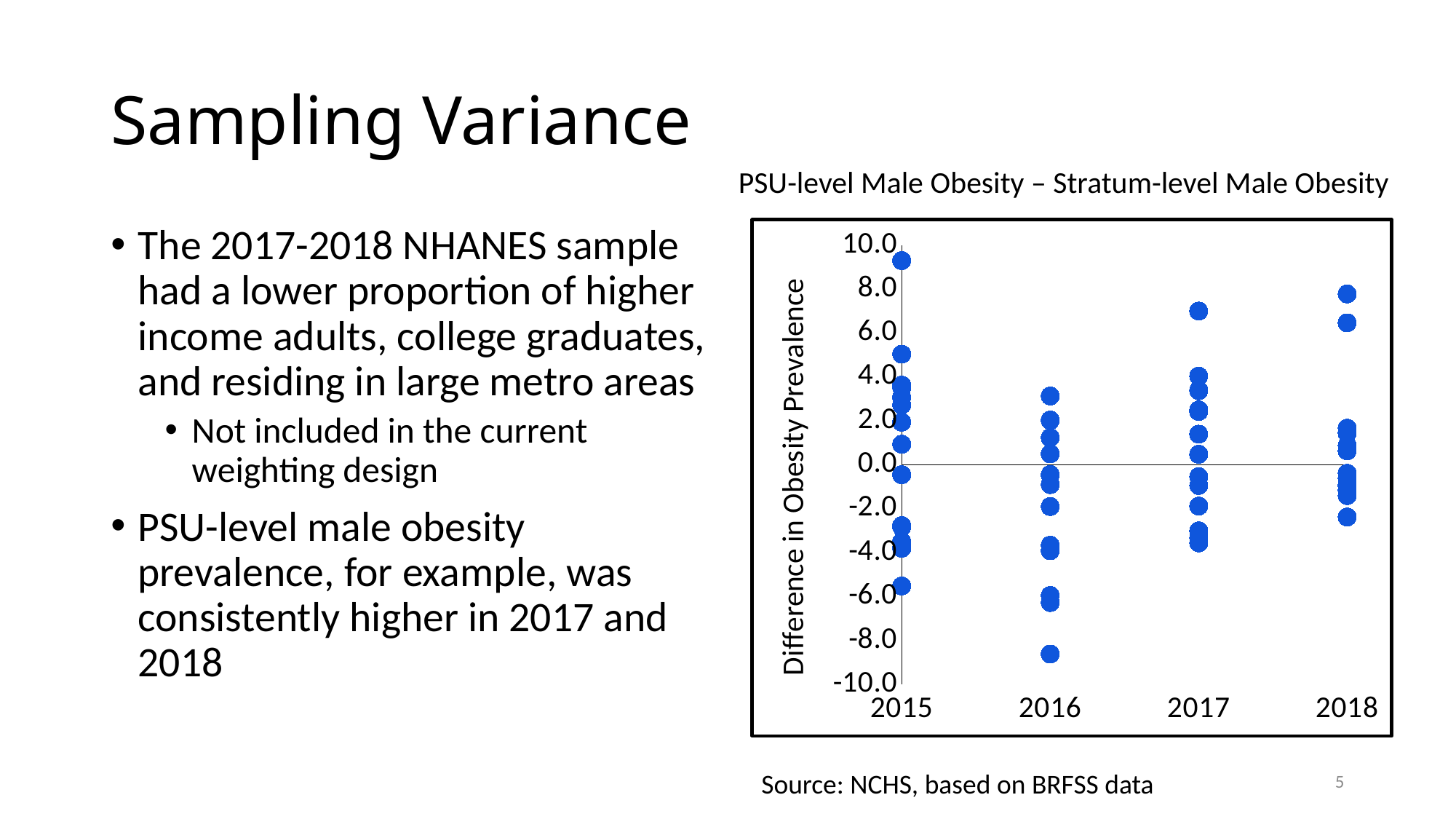
What kind of chart is shown on the slide? scatter chart How many years are shown along the x axis of the chart? 4 Is the lowest point for 2018 greater or less than -4.0? greater Which year has the single lowest point on the chart? 2016 Which year has the single highest point on the chart? 2015 Is the highest point for 2017 greater or less than 6.0? greater Is the highest point for 2016 greater or less than 4.0? less What is the title of the chart? PSU-level Male Obesity – Stratum-level Male Obesity What is the label of the chart's y axis? Difference in Obesity Prevalence